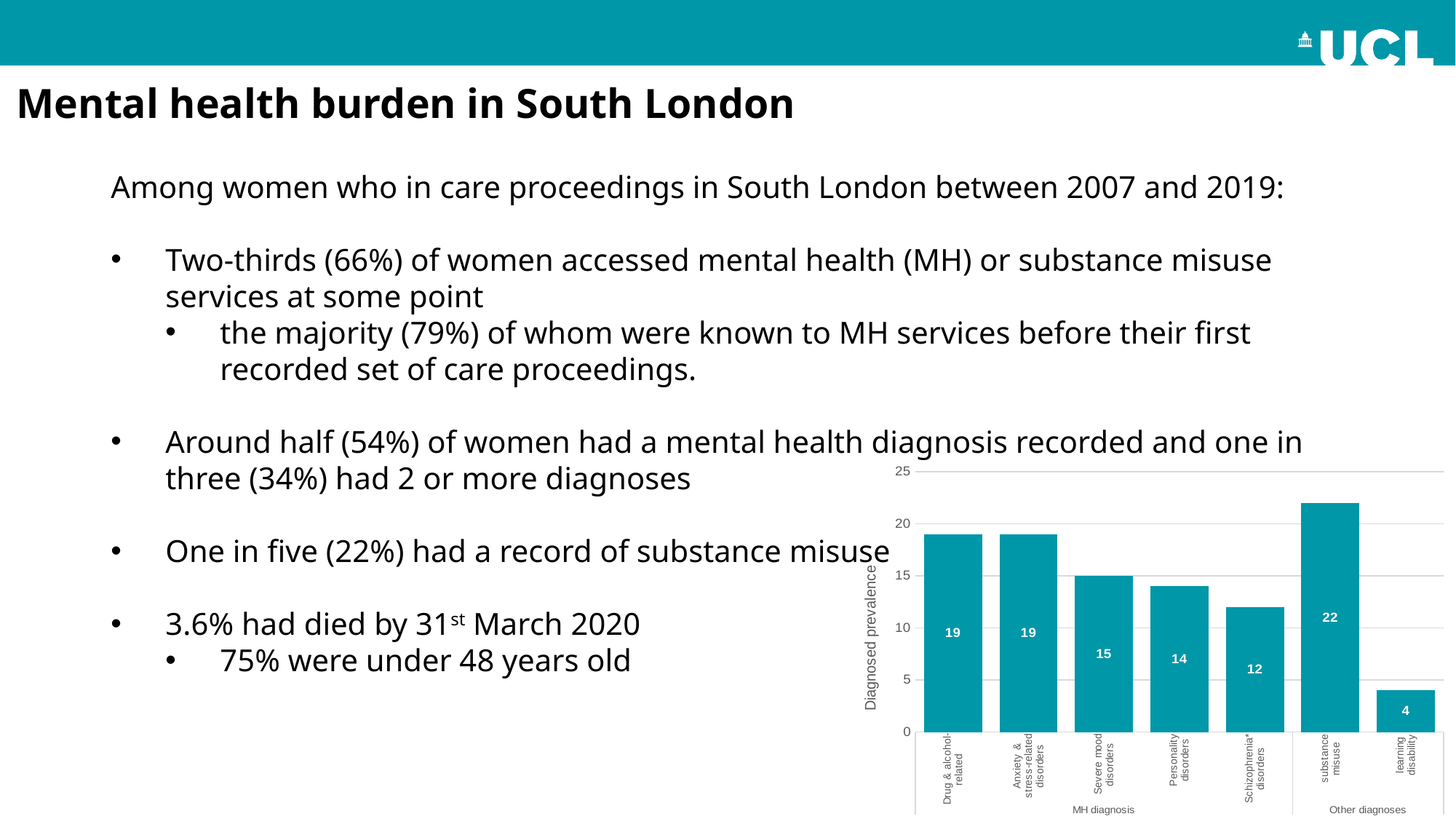
What is the diagnosed prevalence for Severe mood disorders? 15 What kind of chart is shown on the slide? Bar chart Which category has the highest diagnosed prevalence? substance misuse What is the diagnosed prevalence for Schizophrenia* disorders? 12 What is the label of the vertical axis of the chart? Diagnosed prevalence What is the diagnosed prevalence for Personality disorders? 14 Which is larger, the diagnosed prevalence for Severe mood disorders or for Schizophrenia* disorders? Severe mood disorders How many categories are shown in the chart? 7 Which category has the lowest diagnosed prevalence? learning disability What is the difference between the diagnosed prevalence for substance misuse and for learning disability? 18 Is the value for Drug & alcohol-related greater or less than 15? greater What is the diagnosed prevalence for substance misuse? 22